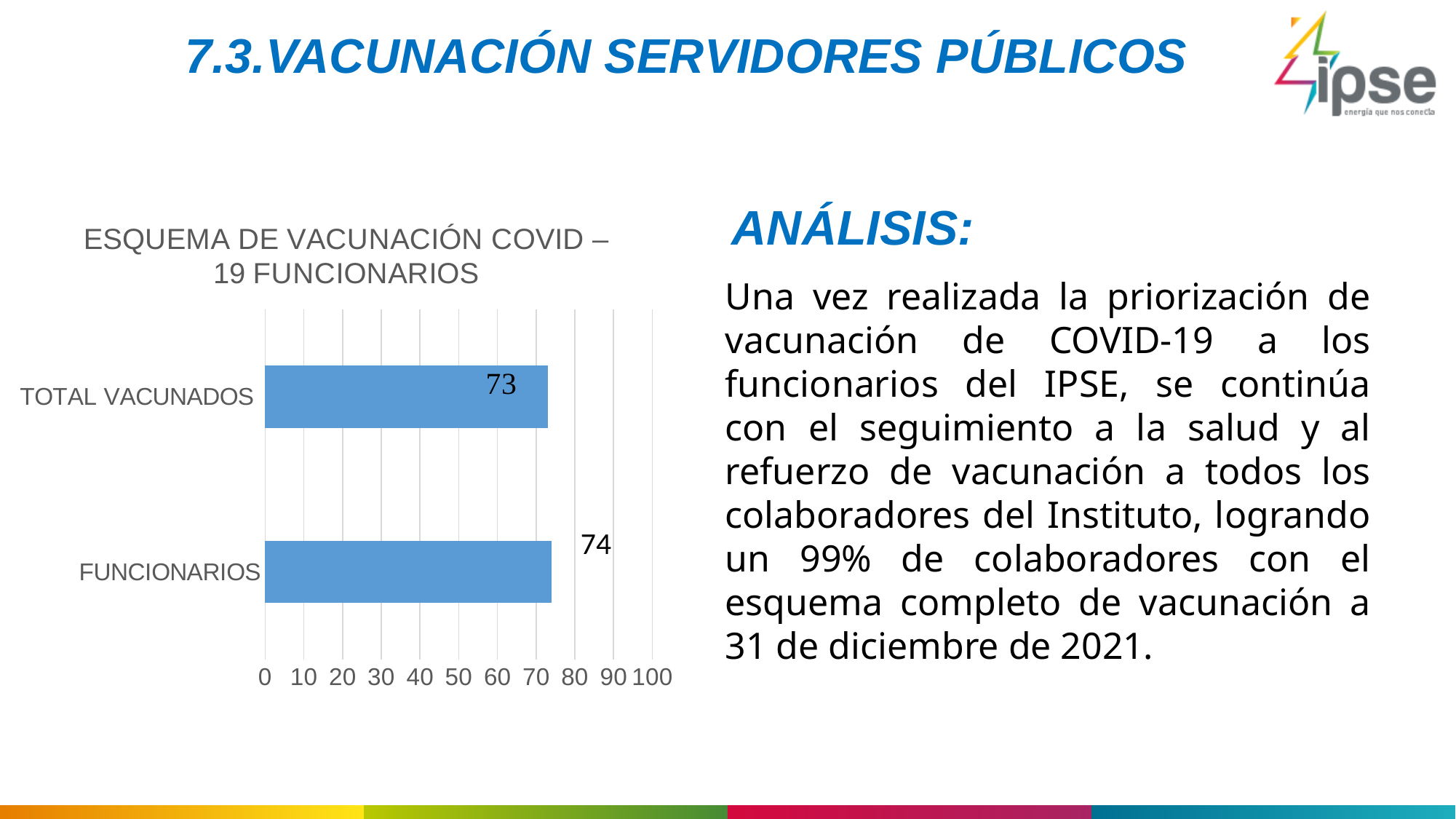
What is the difference between the values for FUNCIONARIOS and TOTAL VACUNADOS? 1 Is the value for TOTAL VACUNADOS greater or less than 80? less Which category has the higher value, FUNCIONARIOS or TOTAL VACUNADOS? FUNCIONARIOS Is the value for FUNCIONARIOS greater or less than 70? greater What is the maximum value shown on the chart's value axis? 100 Which category has the lowest value? TOTAL VACUNADOS What kind of chart is shown on the slide? Bar chart What is the title of the chart? ESQUEMA DE VACUNACIÓN COVID – 19 FUNCIONARIOS What is the value for FUNCIONARIOS? 74 How many categories are shown in the chart? 2 What is the value for TOTAL VACUNADOS? 73